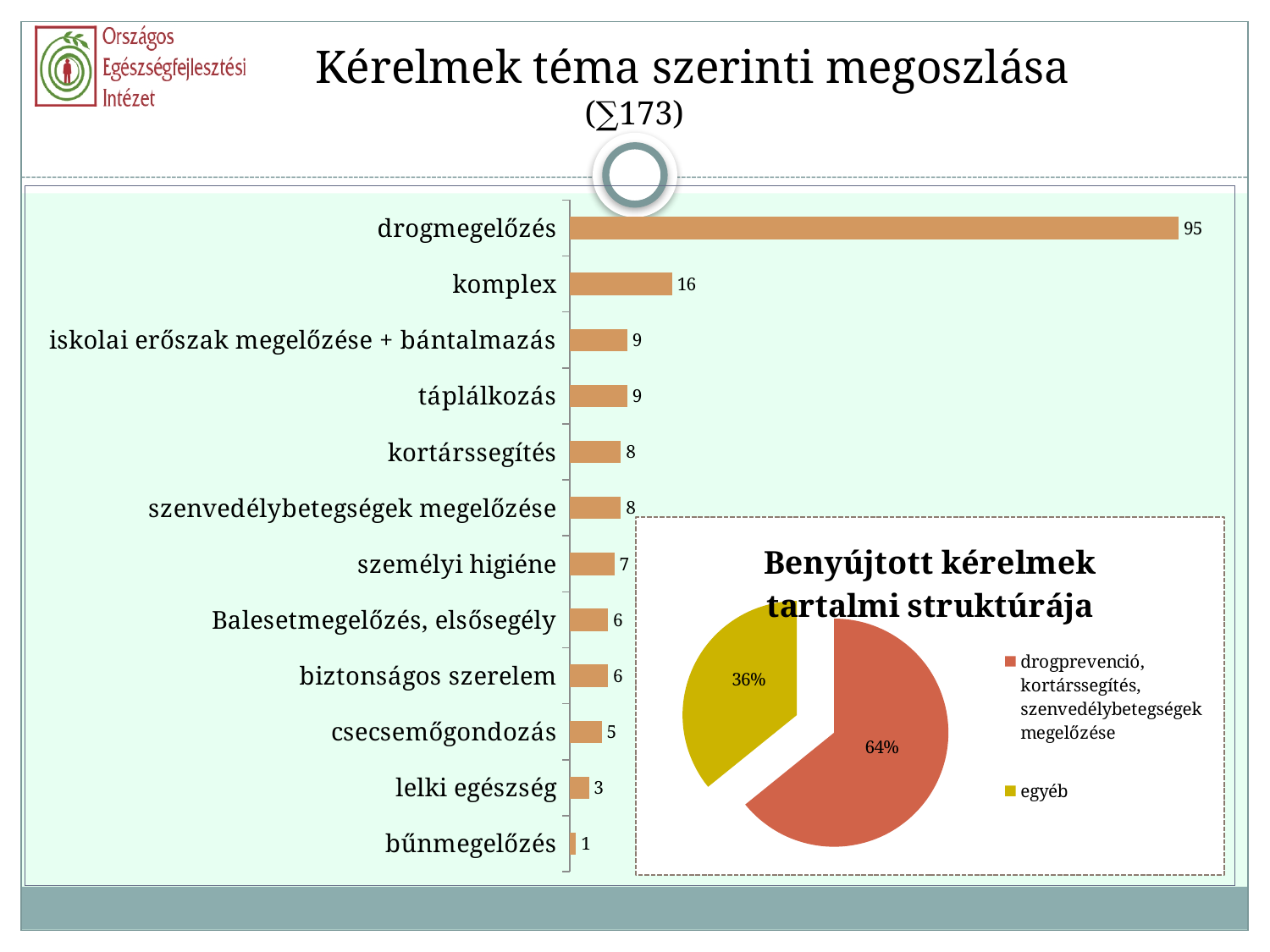
In the bar chart on the left, what is the value for drogmegelőzés? 95 In the pie chart titled 'Benyújtott kérelmek tartalmi struktúrája', what share does the slice for drogprevenció, kortárssegítés, szenvedélybetegségek megelőzése have? 64% In the bar chart on the left, what is the value for csecsemőgondozás? 5 How many categories does the bar chart on the left show? 12 In the bar chart on the left, which category has the highest value? drogmegelőzés In the bar chart on the left, what is the value for komplex? 16 In the bar chart on the left, which is larger: the value for személyi higiéne or the value for lelki egészség? személyi higiéne In the bar chart on the left, which category has the lowest value? bűnmegelőzés What kind of chart is the chart on the left of the slide? bar chart How many entries does the legend of the pie chart titled 'Benyújtott kérelmek tartalmi struktúrája' list? 2 In the bar chart on the left, what is the difference between the values for drogmegelőzés and komplex? 79 In the pie chart titled 'Benyújtott kérelmek tartalmi struktúrája', what share does egyéb have? 36%